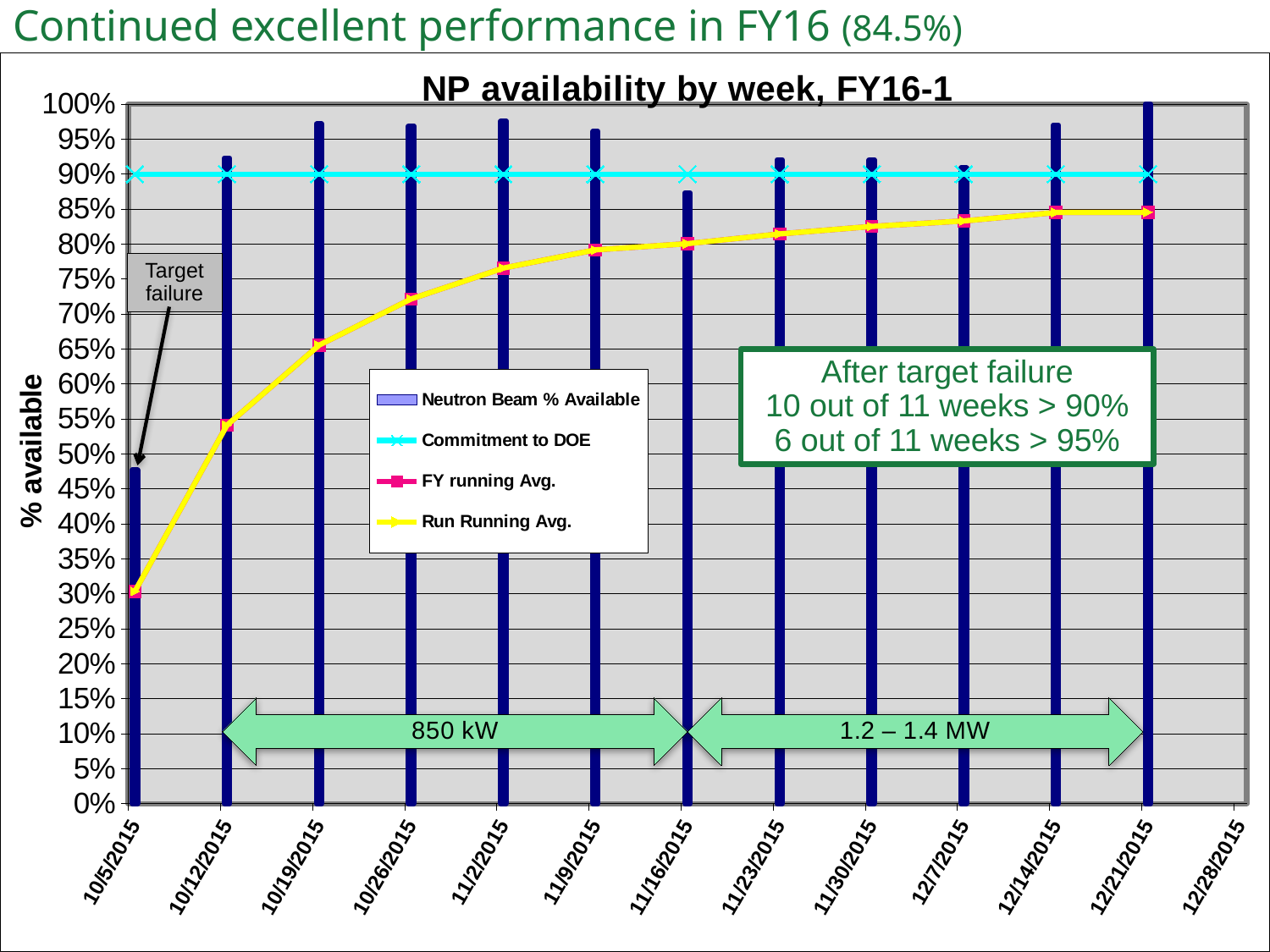
Does the Run Running Avg. line rise or fall from 10/5/2015 to 12/21/2015? rise Is the Neutron Beam % Available for 10/5/2015 greater or less than 50%? less How many weeks have a Neutron Beam % Available bar plotted? 12 Which week has the larger Neutron Beam % Available bar, 10/12/2015 or 10/19/2015? 10/19/2015 Which week has the highest Neutron Beam % Available bar? 12/21/2015 Is the Neutron Beam % Available for 11/16/2015 greater or less than 90%? less What is the title of the chart? NP availability by week, FY16-1 What kind of chart is used to show Neutron Beam % Available? bar chart How many series does the legend list? 4 Which week has the lowest Neutron Beam % Available bar? 10/5/2015 At what level is the Commitment to DOE line drawn? 90% Is the Neutron Beam % Available for 11/2/2015 greater or less than 95%? greater